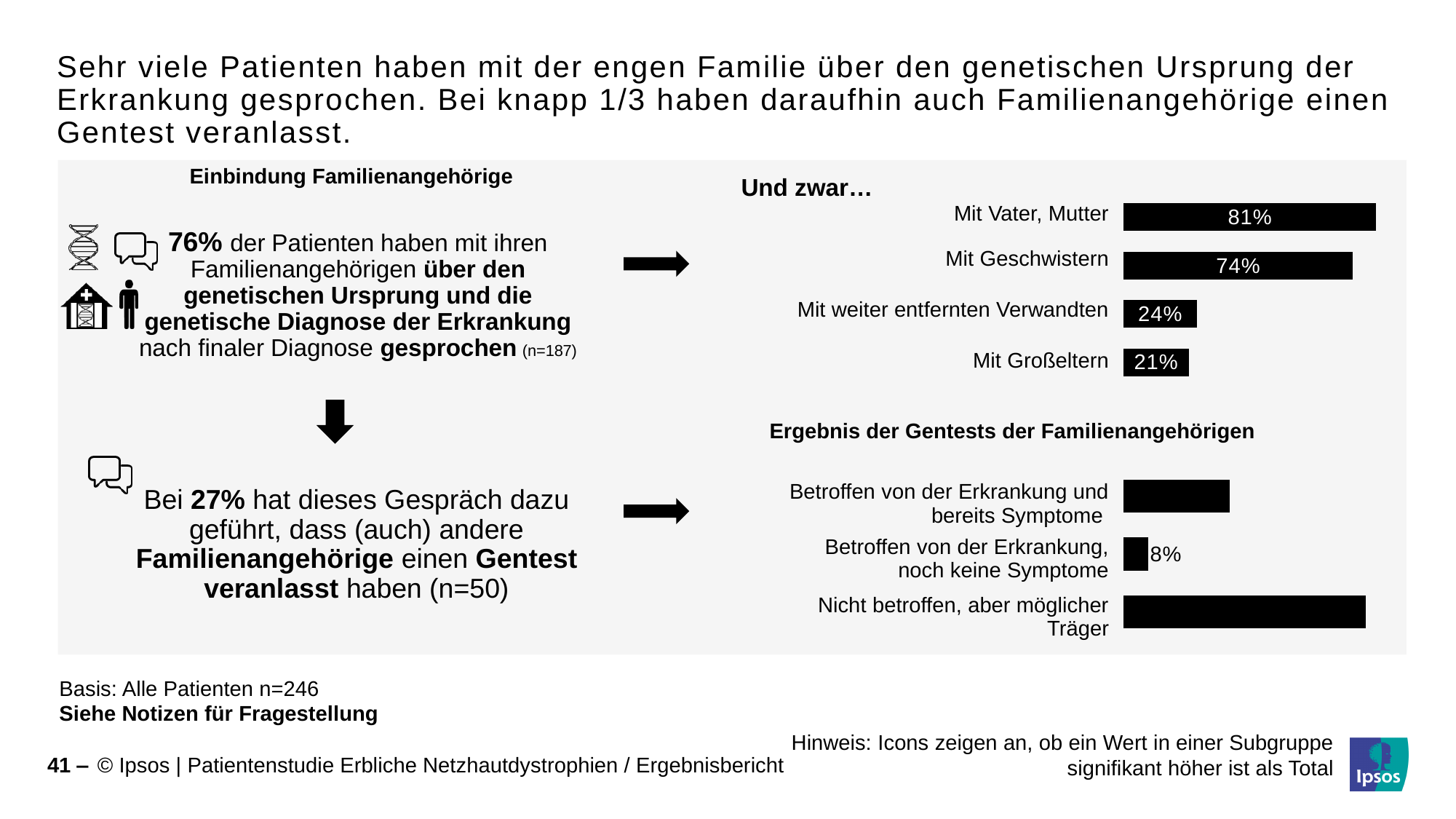
In the 'Und zwar…' chart, what is the difference between 'Mit Vater, Mutter' and 'Mit Geschwistern'? 7% In the 'Ergebnis der Gentests der Familienangehörigen' chart, what is the value for 'Betroffen von der Erkrankung, noch keine Symptome'? 8% In the 'Und zwar…' chart, what is the value for 'Mit Geschwistern'? 74% In the 'Und zwar…' chart, what is the value for 'Mit Großeltern'? 21% In the 'Und zwar…' chart, how many categories are shown? 4 In the 'Und zwar…' chart, which category has the lowest value? Mit Großeltern In the 'Und zwar…' chart, what is the value for 'Mit Vater, Mutter'? 81% In the 'Und zwar…' chart, which category has the highest value? Mit Vater, Mutter In the 'Und zwar…' chart, what is the value for 'Mit weiter entfernten Verwandten'? 24% In the 'Ergebnis der Gentests der Familienangehörigen' chart, which category has the longest bar? Nicht betroffen, aber möglicher Träger In the 'Ergebnis der Gentests der Familienangehörigen' chart, how many categories are shown? 3 What kind of chart is the 'Und zwar…' chart? Bar chart